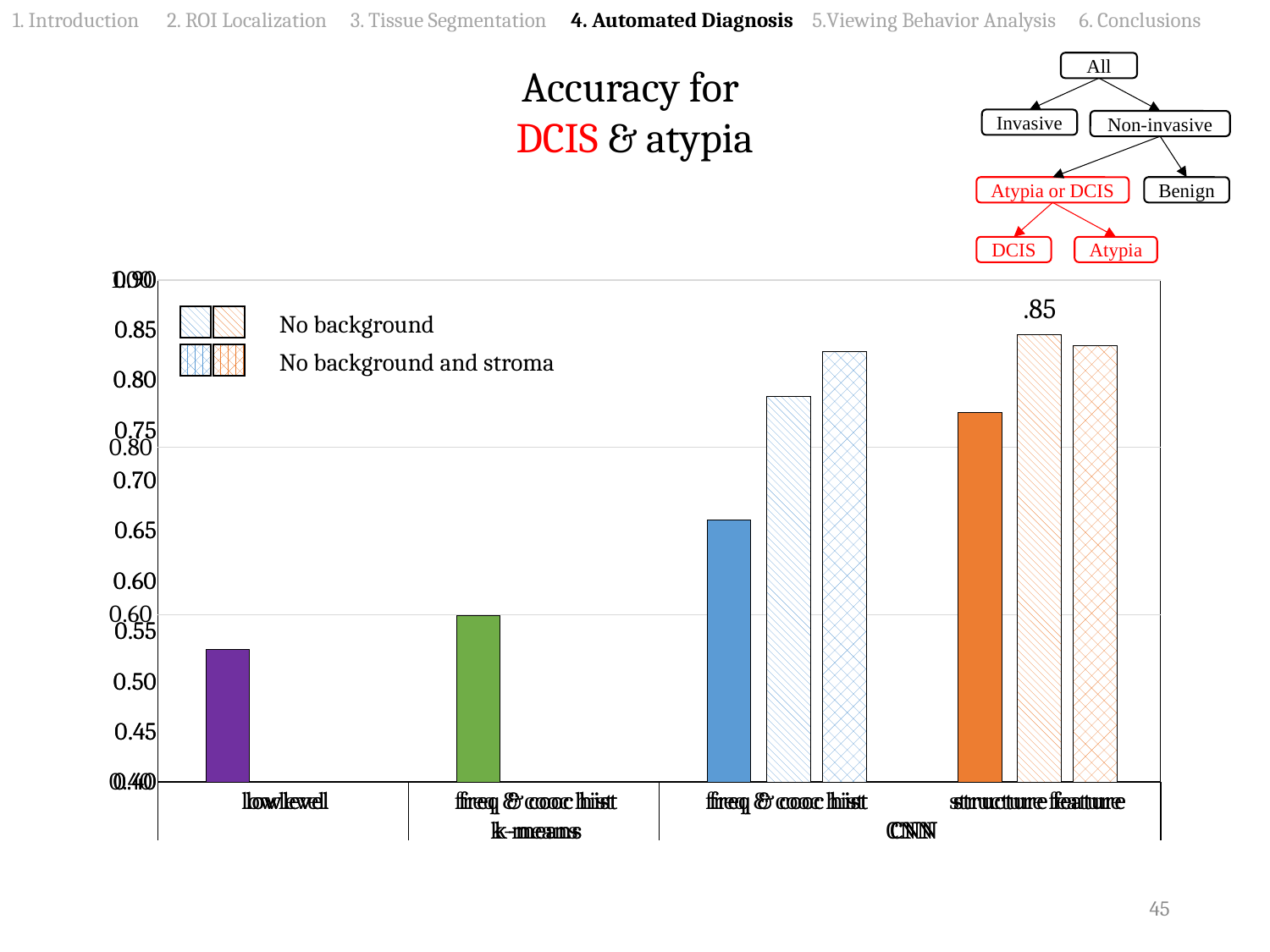
Is the value of the solid bar for low level greater or less than 0.60? less Which solid bar is taller: low level or freq & cooc hist (k-means)? freq & cooc hist (k-means) Which category has the lowest solid bar in the chart? low level What are the two entries in the chart legend? No background; No background and stroma What is the title of the chart? Accuracy for DCIS & atypia Which solid bar is taller: freq & cooc hist (CNN) or structure feature (CNN)? structure feature (CNN) How many series does the chart legend list? 2 What value is printed above the 'No background' bar for structure feature (CNN)? .85 What kind of chart is shown on the slide? bar chart Which category has the tallest bar in the chart? structure feature (CNN) How many categories are shown along the x axis of the chart? 4 Do the solid bars rise or fall from left to right across the categories? rise